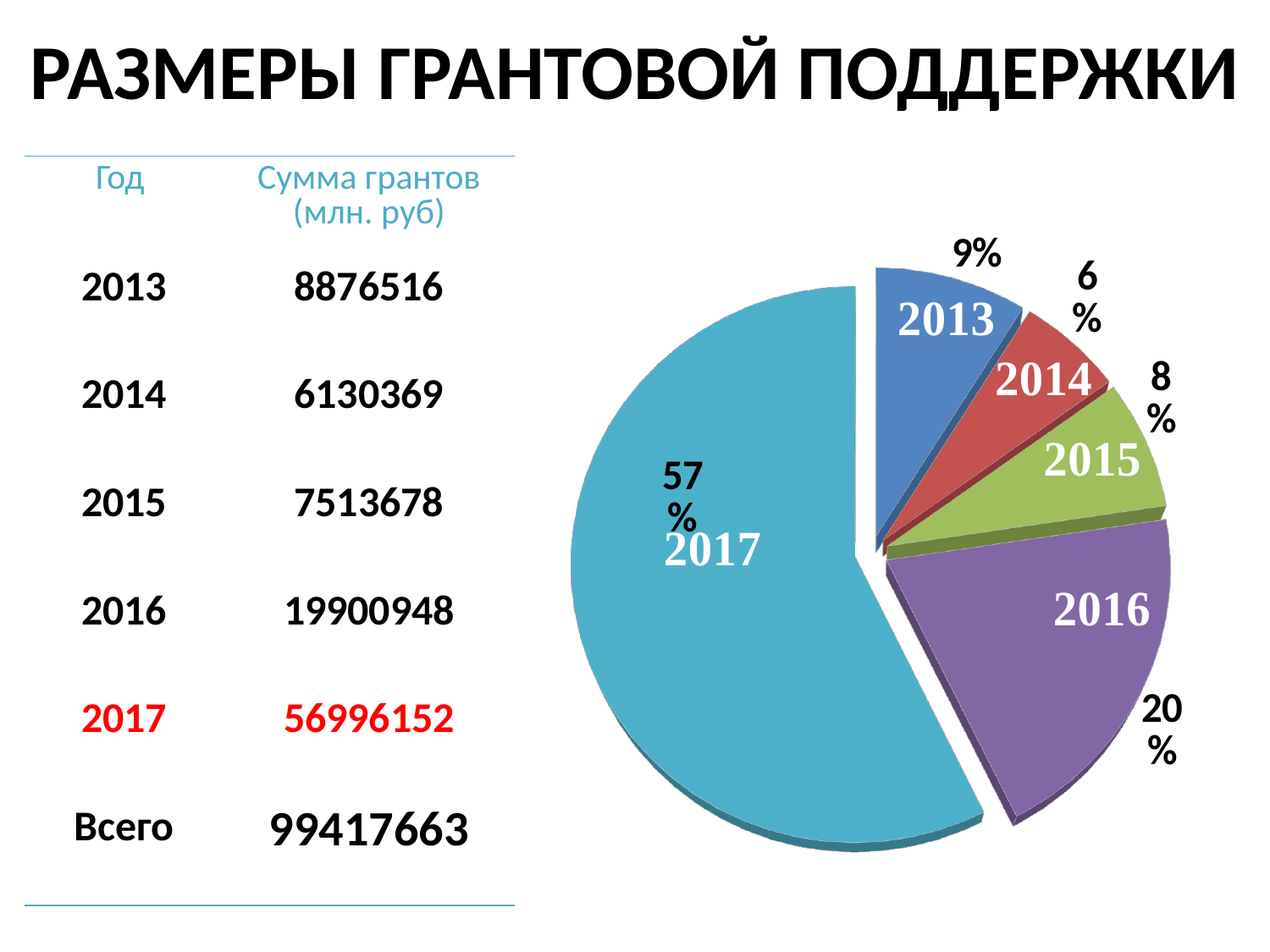
What percentage does the 2017 slice of the pie chart show? 57% Which slice is larger in the pie chart, 2013 or 2015? 2013 What kind of chart is shown on the slide? pie chart What percentage does the 2015 slice of the pie chart show? 8% What percentage does the 2016 slice of the pie chart show? 20% How many slices does the pie chart have? 5 What percentage does the 2014 slice of the pie chart show? 6% What percentage does the 2013 slice of the pie chart show? 9% Which year has the largest slice in the pie chart? 2017 What is the difference in percentage points between the 2017 slice and the 2016 slice? 37 What colour is the 2017 slice of the pie chart? light blue (cyan) Which year has the smallest slice in the pie chart? 2014